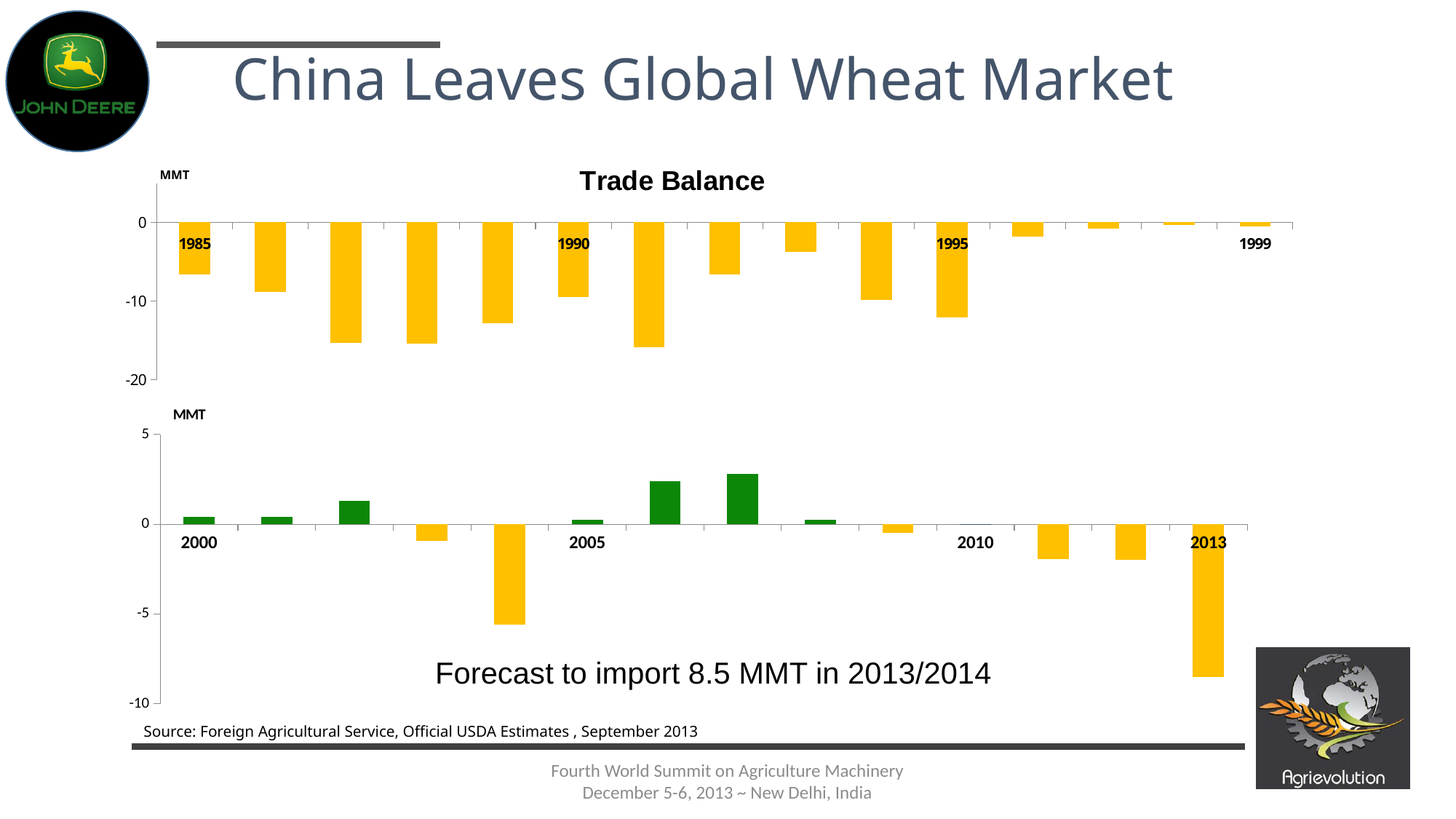
In the top chart (1985–1999), how many years are plotted? 15 In the top chart, which year has the larger deficit, 1985 or 1987? 1987 In the bottom chart, which year has the lowest (most negative) trade balance? 2013 What type of chart is used to show the trade balance? bar chart In the bottom chart, is the value for 2011 greater or less than -5? greater In the top chart, is the value for 1985 greater or less than -10? greater What is the title of the chart on the slide? Trade Balance In the bottom chart, do the values rise or fall from 2010 to 2013? fall What is the forecast wheat import for 2013/2014 stated on the slide? 8.5 MMT In the bottom chart, is the value for 2004 greater or less than -5? less In the bottom chart (2000–2013), how many years are plotted? 14